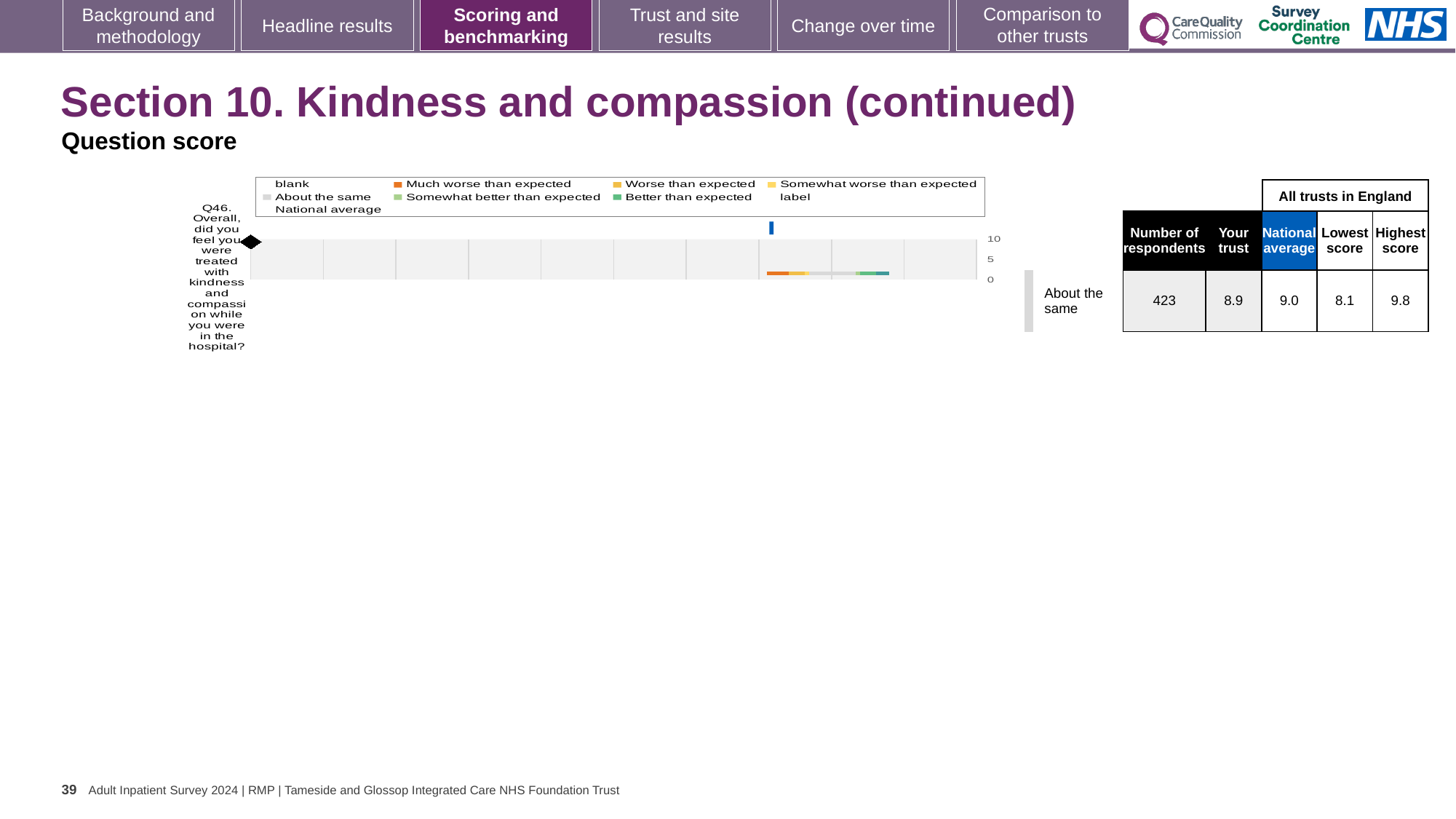
How many respondents are shown for Q46? 423 What is the highest score among all trusts in England for Q46? 9.8 What is the lowest score among all trusts in England for Q46? 8.1 Is the 'Your trust' score for Q46 greater or less than 5? greater What is the difference between the highest score and the lowest score for Q46? 1.7 Which survey question does the chart relate to? Q46. Overall, did you feel you were treated with kindness and compassion while you were in the hospital? What kind of chart is shown on the slide? bar chart Which benchmarking category is the trust's Q46 score placed in? About the same What is the 'Your trust' score for Q46? 8.9 Which is larger for Q46, the 'Your trust' score or the national average? National average What is the national average score for Q46? 9.0 What is the highest tick value shown on the chart's score axis? 10